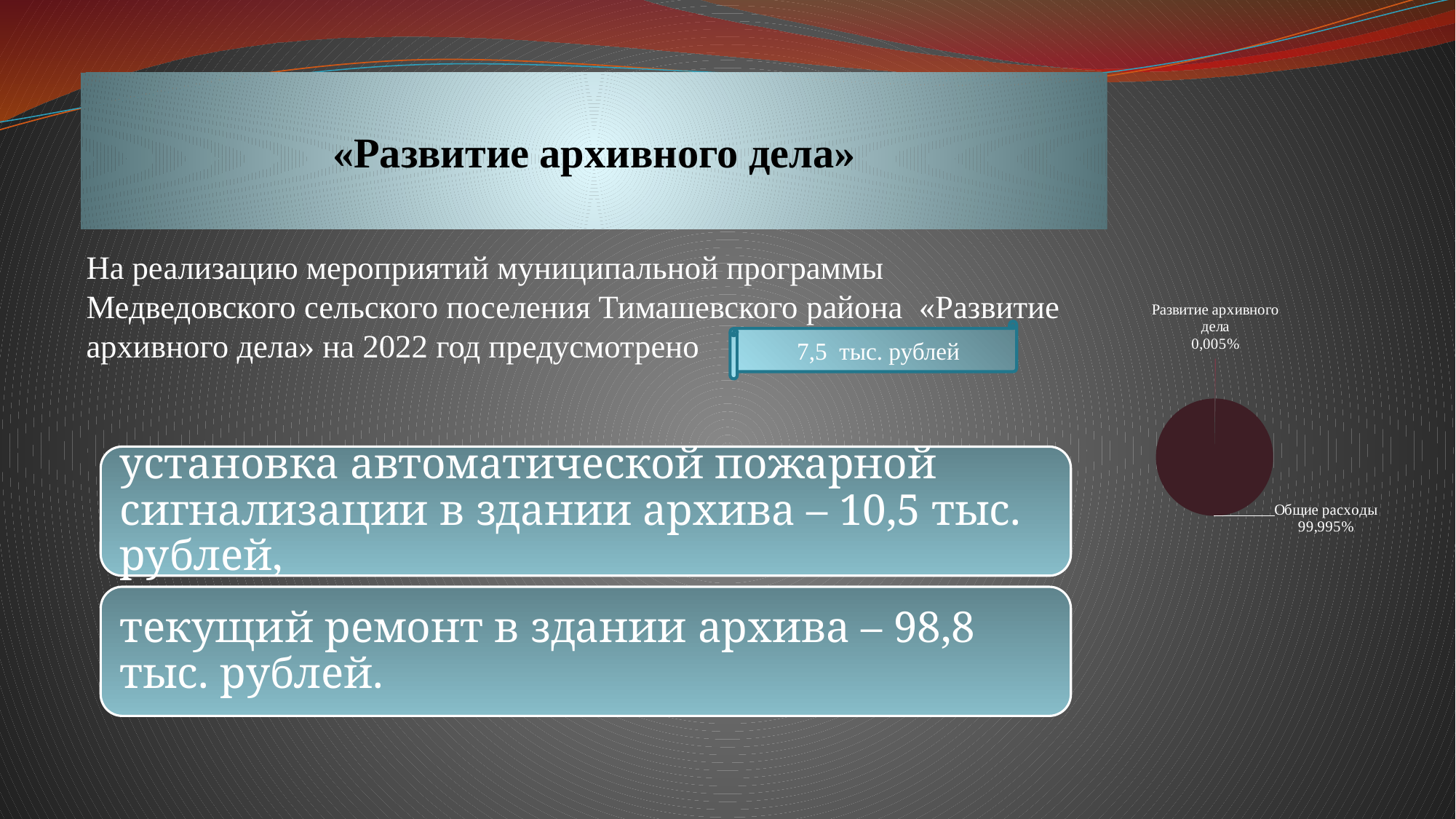
Is the share for «Развитие архивного дела» in the pie chart greater or less than 1%? less How many slices does the pie chart have? 2 Is the share for «Общие расходы» in the pie chart greater or less than 50%? greater Which slice of the pie chart is the smallest? Развитие архивного дела Which slice of the pie chart is the largest? Общие расходы What kind of chart is shown on the right side of the slide? pie chart Which is larger in the pie chart: «Общие расходы» or «Развитие архивного дела»? Общие расходы What share of the pie chart is labelled for «Общие расходы»? 99,995% What is the difference in percentage points between the «Общие расходы» slice and the «Развитие архивного дела» slice? 99,99% What share of the pie chart is labelled for «Развитие архивного дела»? 0,005% What colour is the «Общие расходы» slice of the pie chart? dark red